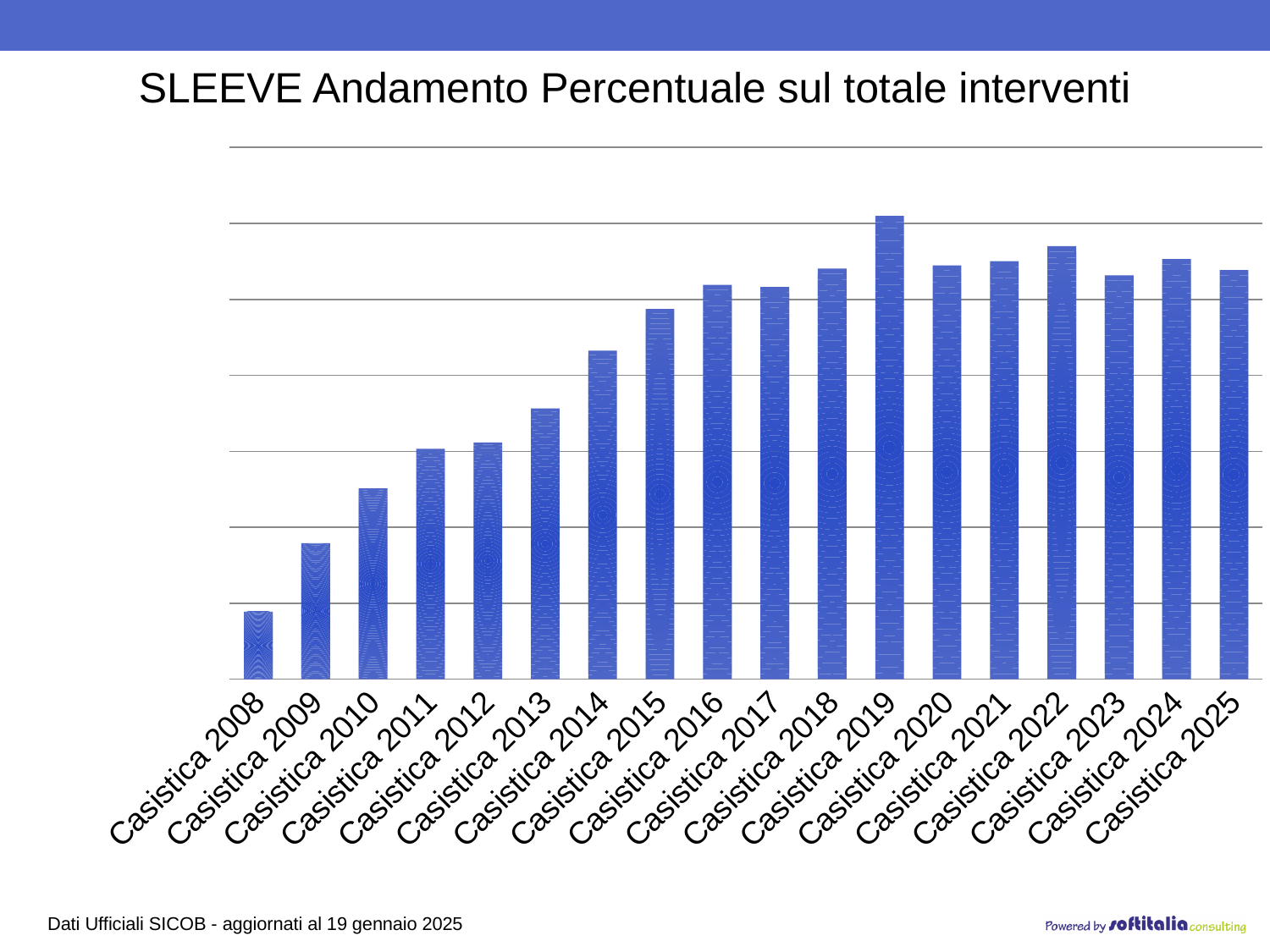
Which is larger, the value for Casistica 2009 or Casistica 2011? Casistica 2011 Which is larger, the value for Casistica 2015 or Casistica 2018? Casistica 2018 What kind of chart is shown on the slide? Bar chart Do the values rise or fall from Casistica 2019 to Casistica 2020? Fall What is the first category on the x axis? Casistica 2008 Which category has the lowest bar? Casistica 2008 Which is larger, the value for Casistica 2014 or Casistica 2010? Casistica 2014 How many categories (bars) are plotted on the chart? 18 Which category has the highest bar? Casistica 2019 What is the title of the chart? SLEEVE Andamento Percentuale sul totale interventi Do the values rise or fall from Casistica 2008 to Casistica 2014? Rise